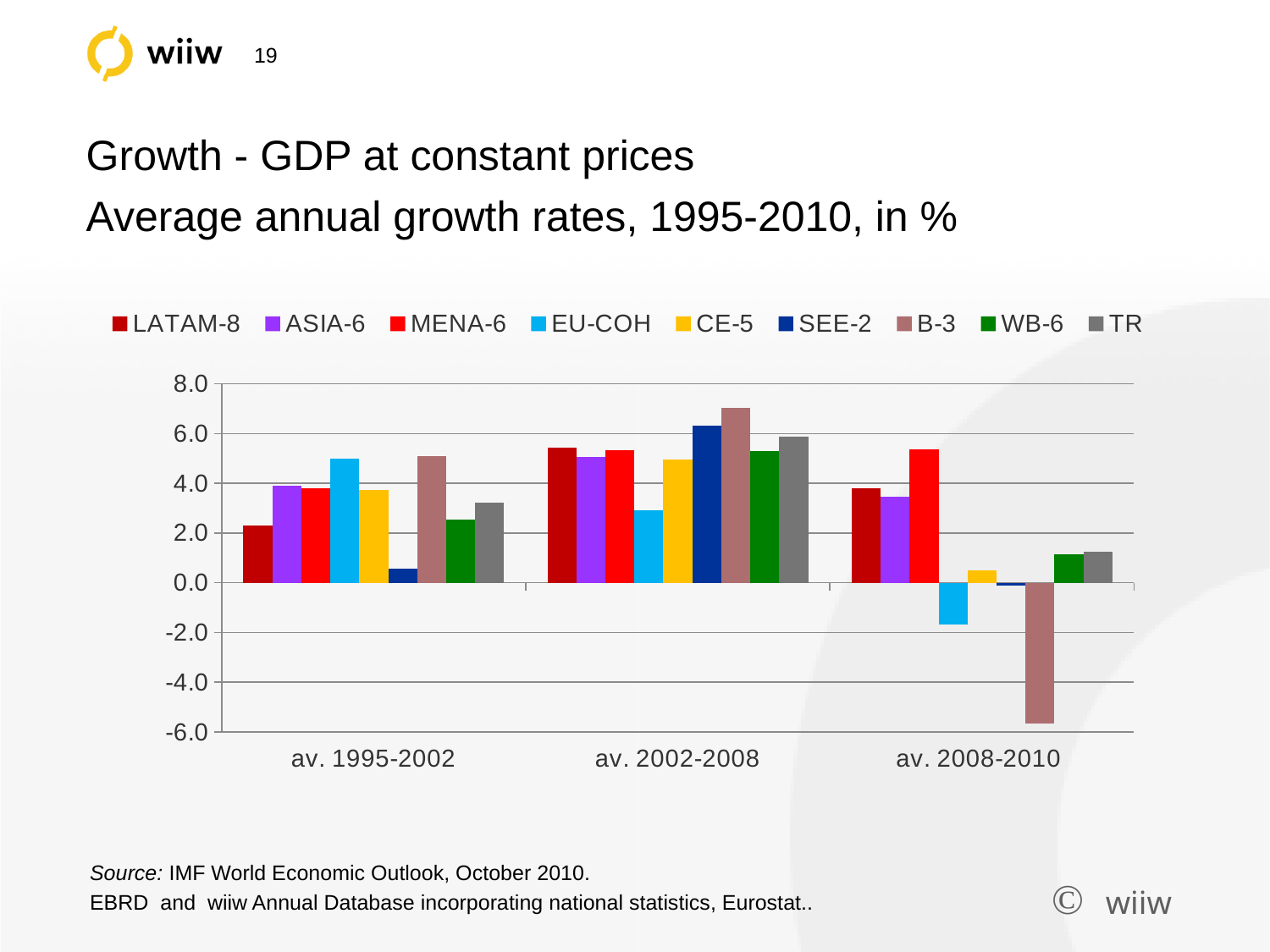
Is the value for B-3 in av. 2008-2010 greater or less than -4.0? less Is the value for EU-COH in av. 2008-2010 greater or less than 0.0? less How many period categories are shown on the x axis? 3 Is the value for EU-COH in av. 1995-2002 greater or less than 4.0? greater Which region has the highest average growth rate in av. 2008-2010? MENA-6 What kind of chart is shown on the slide? bar chart Which region has the highest average growth rate in av. 2002-2008? B-3 Which region has the lowest average growth rate in av. 2008-2010? B-3 How many series does the legend list? 9 Which region has the lowest average growth rate in av. 1995-2002? SEE-2 In av. 1995-2002, which is larger: LATAM-8 or EU-COH? EU-COH Do the values for EU-COH rise or fall across the three periods from av. 1995-2002 to av. 2008-2010? fall